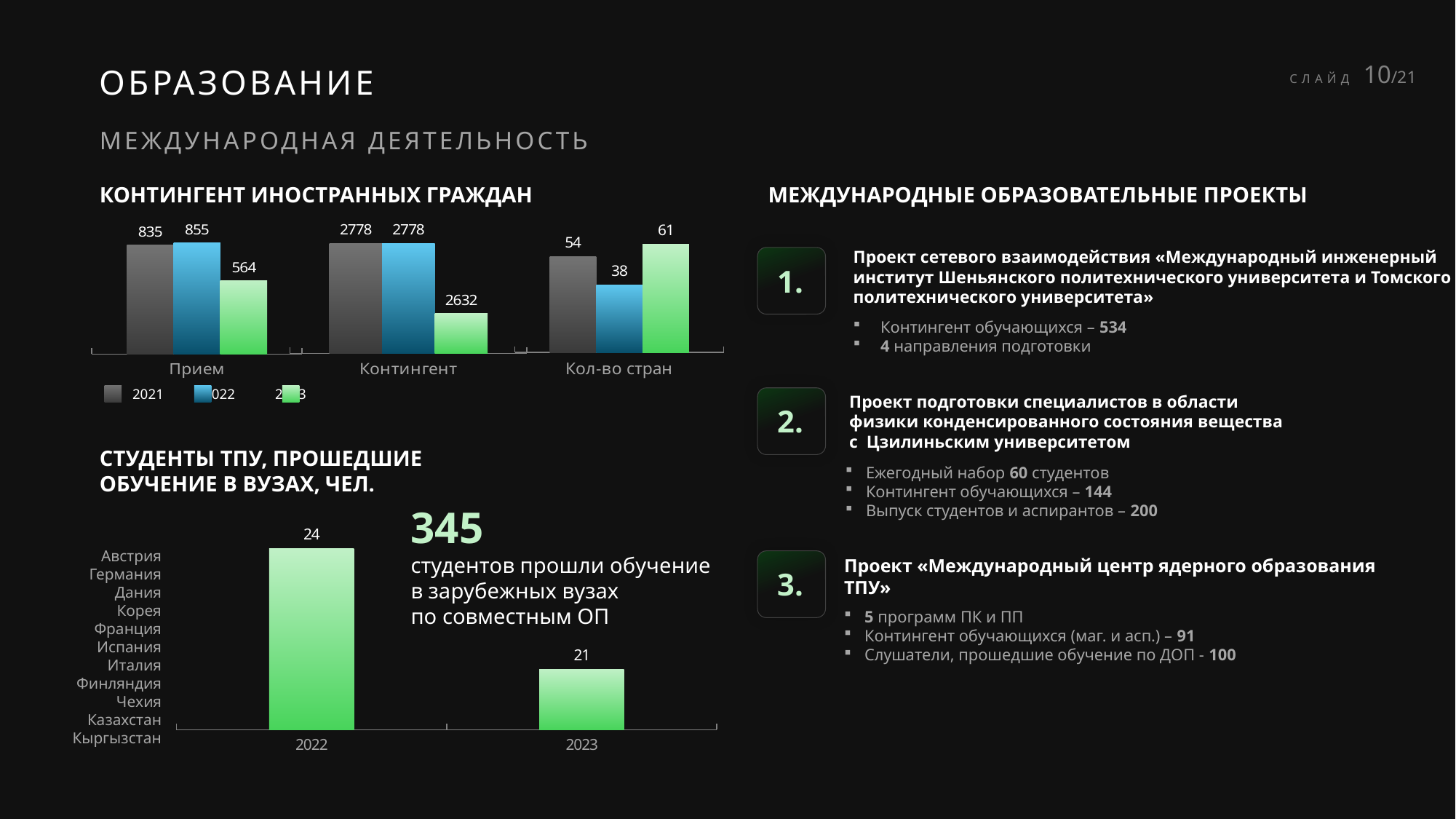
In the chart 'КОНТИНГЕНТ ИНОСТРАННЫХ ГРАЖДАН', what is the value for 'Прием' in 2021? 835 In the chart 'КОНТИНГЕНТ ИНОСТРАННЫХ ГРАЖДАН', what is the value for 'Кол-во стран' in 2022? 38 What type of chart is 'СТУДЕНТЫ ТПУ, ПРОШЕДШИЕ ОБУЧЕНИЕ В ВУЗАХ, ЧЕЛ.'? Bar chart In the chart 'КОНТИНГЕНТ ИНОСТРАННЫХ ГРАЖДАН', what is the difference between the 'Прием' values for 2022 and 2023? 291 How many categories are shown on the x axis of the chart 'КОНТИНГЕНТ ИНОСТРАННЫХ ГРАЖДАН'? 3 In the chart 'КОНТИНГЕНТ ИНОСТРАННЫХ ГРАЖДАН', which year has the lowest value for 'Прием'? 2023 In the chart 'КОНТИНГЕНТ ИНОСТРАННЫХ ГРАЖДАН', which year has the highest value for 'Кол-во стран'? 2023 In the chart 'КОНТИНГЕНТ ИНОСТРАННЫХ ГРАЖДАН', is the 'Кол-во стран' value larger in 2021 or in 2022? 2021 In the chart 'СТУДЕНТЫ ТПУ, ПРОШЕДШИЕ ОБУЧЕНИЕ В ВУЗАХ, ЧЕЛ.', what is the value for 2022? 24 In the chart 'СТУДЕНТЫ ТПУ, ПРОШЕДШИЕ ОБУЧЕНИЕ В ВУЗАХ, ЧЕЛ.', do the values rise or fall from 2022 to 2023? Fall In the chart 'КОНТИНГЕНТ ИНОСТРАННЫХ ГРАЖДАН', what is the value for 'Контингент' in 2023? 2632 How many series does the legend of the chart 'КОНТИНГЕНТ ИНОСТРАННЫХ ГРАЖДАН' list? 3